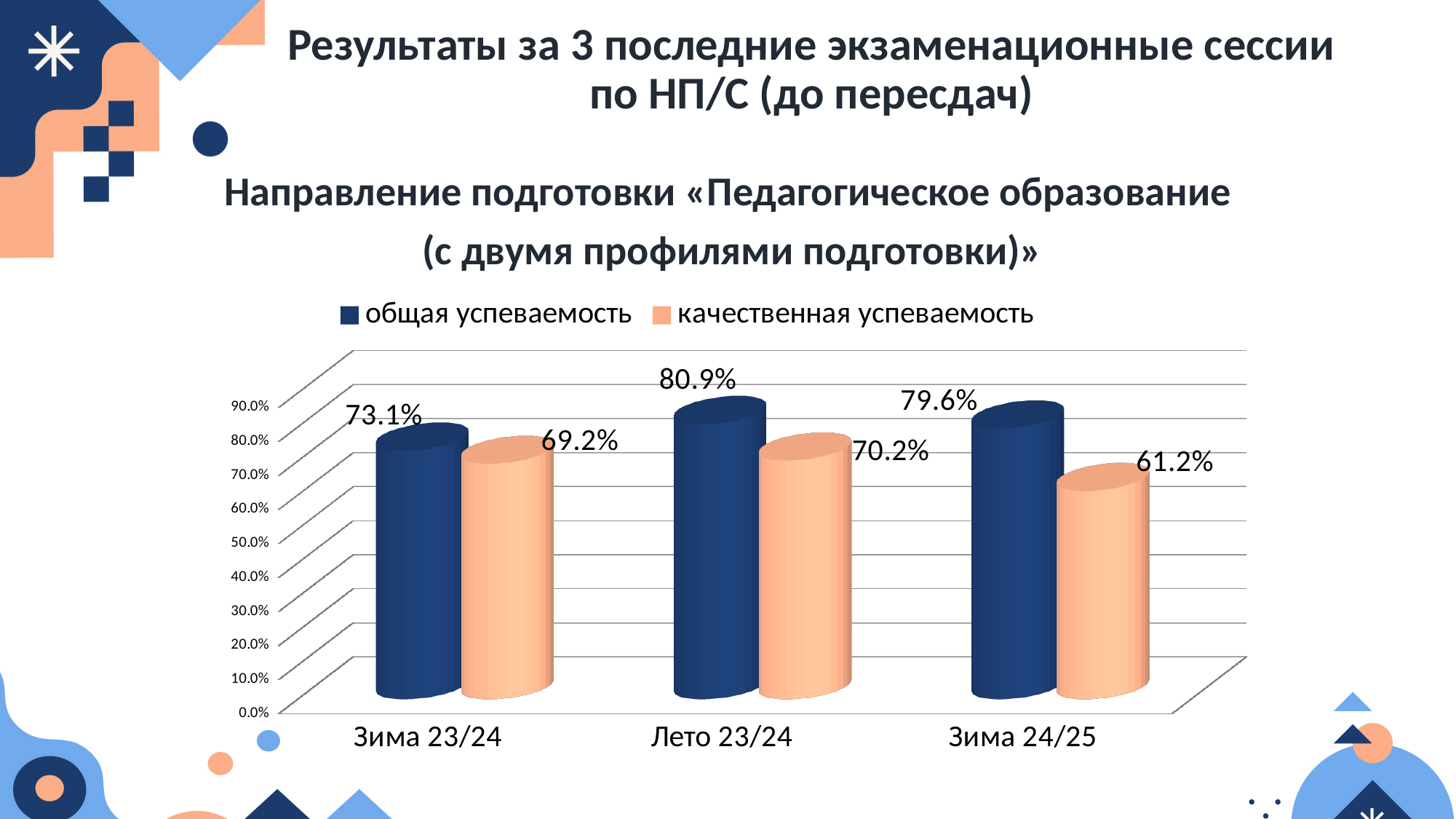
What kind of chart is shown on the slide? Bar chart Which colour represents общая успеваемость in the legend? Dark blue What is the value of общая успеваемость for Зима 23/24? 73.1% Which is larger: качественная успеваемость for Зима 23/24 or for Лето 23/24? Лето 23/24 What is the value of качественная успеваемость for Лето 23/24? 70.2% What is the value of качественная успеваемость for Зима 24/25? 61.2% How many sessions are shown on the x axis? 3 Which session has the highest общая успеваемость? Лето 23/24 How many series does the legend list? 2 Which session has the lowest качественная успеваемость? Зима 24/25 What is the difference between общая успеваемость and качественная успеваемость for Зима 24/25? 18.4% Does качественная успеваемость rise or fall from Лето 23/24 to Зима 24/25? Fall